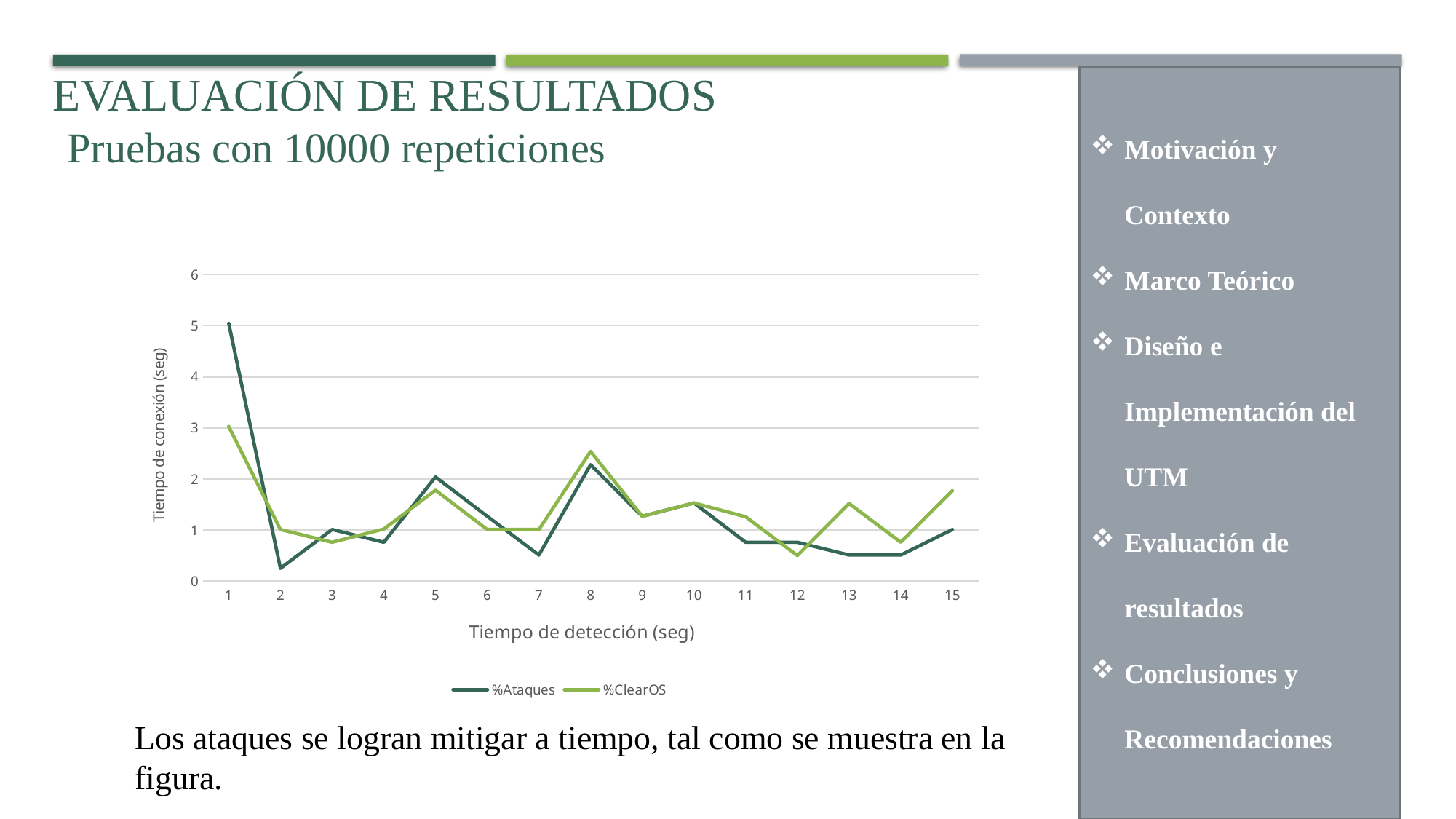
What is the title of the y axis? Tiempo de conexión (seg) What kind of chart is shown on the slide? line chart Is the value of %Ataques at x = 1 greater or less than 4? greater How many points along the x axis does each series have? 15 Is the value of %ClearOS at x = 8 greater or less than 2? greater At which x-axis value does the %Ataques series reach its lowest value? 2 At x = 13, which series has the larger value, %Ataques or %ClearOS? %ClearOS At which x-axis value does the %ClearOS series reach its highest value? 1 At x = 1, which series has the larger value, %Ataques or %ClearOS? %Ataques How many series does the legend list? 2 At which x-axis value does the %Ataques series reach its highest value? 1 Does the %Ataques series rise or fall between x = 1 and x = 2? fall